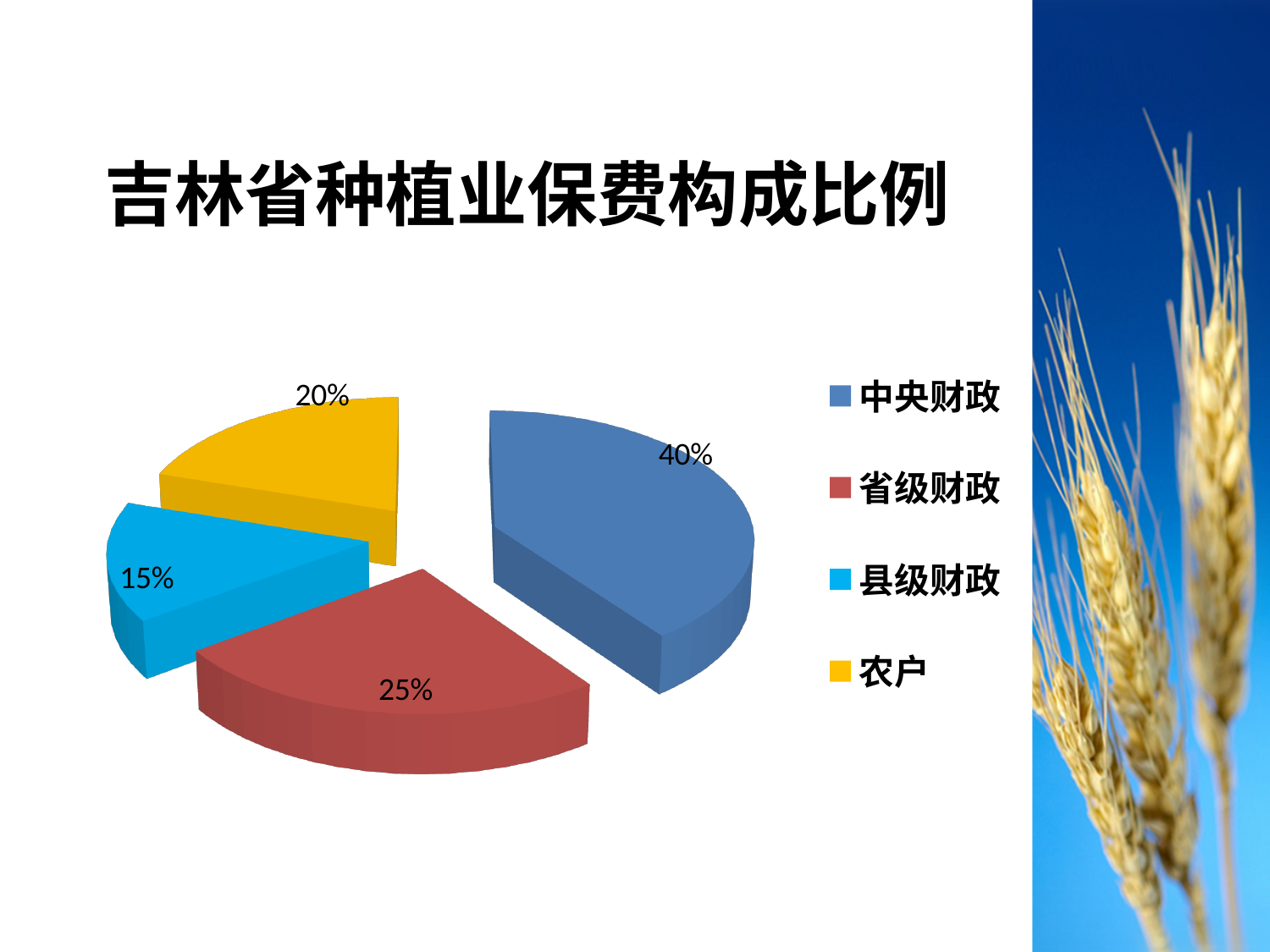
What is the title of the chart? 吉林省种植业保费构成比例 Which category has the smallest share of the pie? 县级财政 What is the difference in percentage points between 中央财政 and 农户? 20% How many categories does the pie chart show? 4 Which category has the largest share of the pie? 中央财政 What share of the pie does 省级财政 account for? 25% What share of the pie does 农户 account for? 20% What share of the pie does 县级财政 account for? 15% What kind of chart is shown on the slide? Pie chart What is the difference in percentage points between 省级财政 and 县级财政? 10% What share of the pie does 中央财政 account for? 40% Which is larger, the share for 农户 or the share for 县级财政? 农户